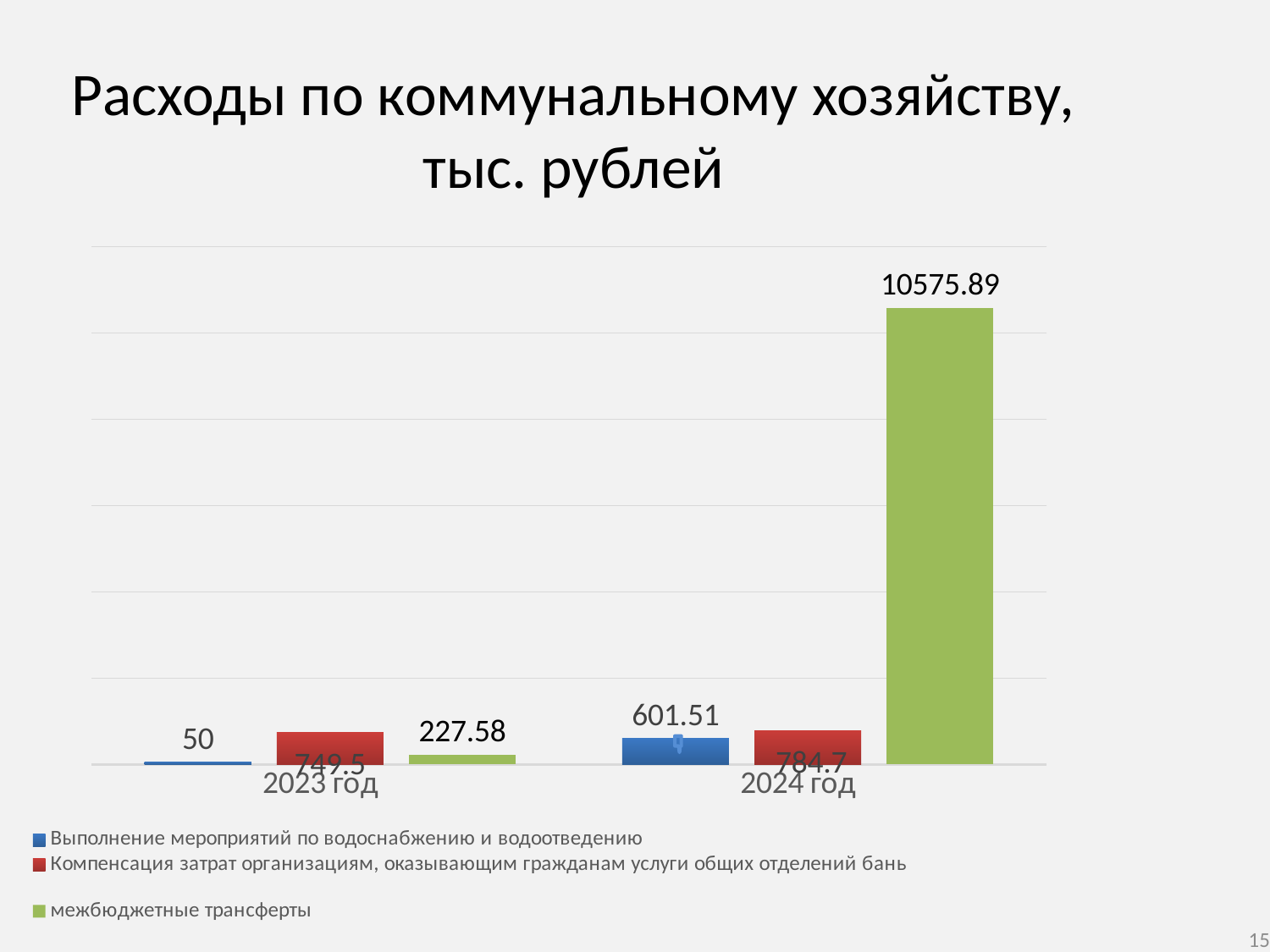
How many series does the legend list? 3 What is the value for Компенсация затрат организациям, оказывающим гражданам услуги общих отделений бань in 2024 год? 784.7 What is the value for межбюджетные трансферты in 2024 год? 10575.89 What is the value for Выполнение мероприятий по водоснабжению и водоотведению in 2023 год? 50 What is the difference between the межбюджетные трансферты values for 2024 год and 2023 год? 10348.31 Which series has the lowest value in 2023 год? Выполнение мероприятий по водоснабжению и водоотведению Which is larger: Выполнение мероприятий по водоснабжению и водоотведению in 2023 год or in 2024 год? 2024 год How many year categories are shown on the x axis? 2 What is the value for Выполнение мероприятий по водоснабжению и водоотведению in 2024 год? 601.51 What is the value for межбюджетные трансферты in 2023 год? 227.58 Which series has the highest value in 2024 год? межбюджетные трансферты What type of chart is shown on the slide? bar chart